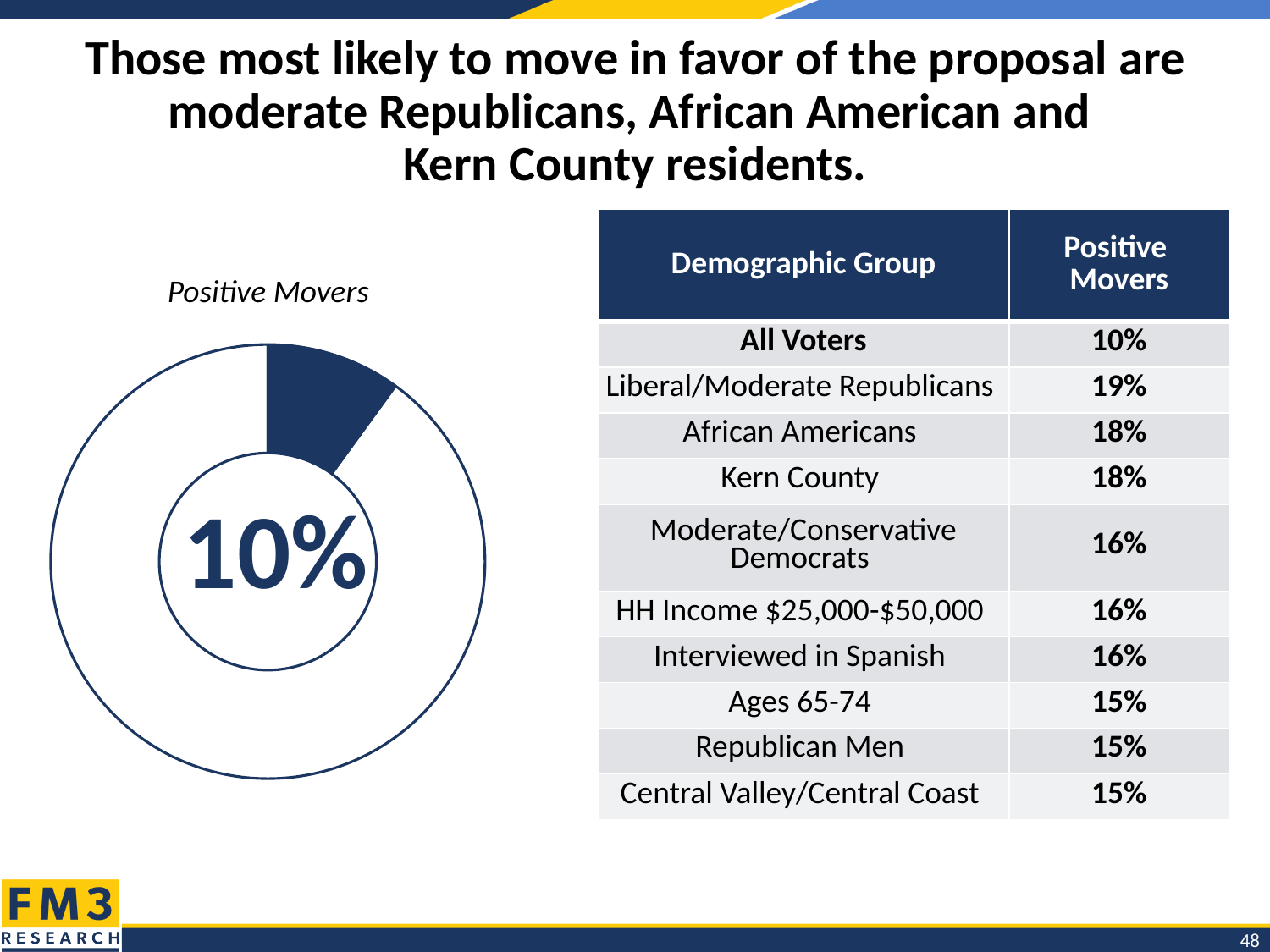
What is the title of the chart on the left of the slide? Positive Movers Is the value shown in the Positive Movers donut chart greater or less than 20%? less What share of the Positive Movers donut chart is not covered by the dark blue slice? 90% What percentage is printed in the center of the Positive Movers donut chart? 10% What kind of chart is shown on the left of the slide? donut chart What colour is the highlighted slice in the Positive Movers donut chart? dark blue What share of the Positive Movers donut chart does the dark blue slice represent? 10% In the Positive Movers donut chart, is the dark blue slice larger or smaller than half of the ring? smaller